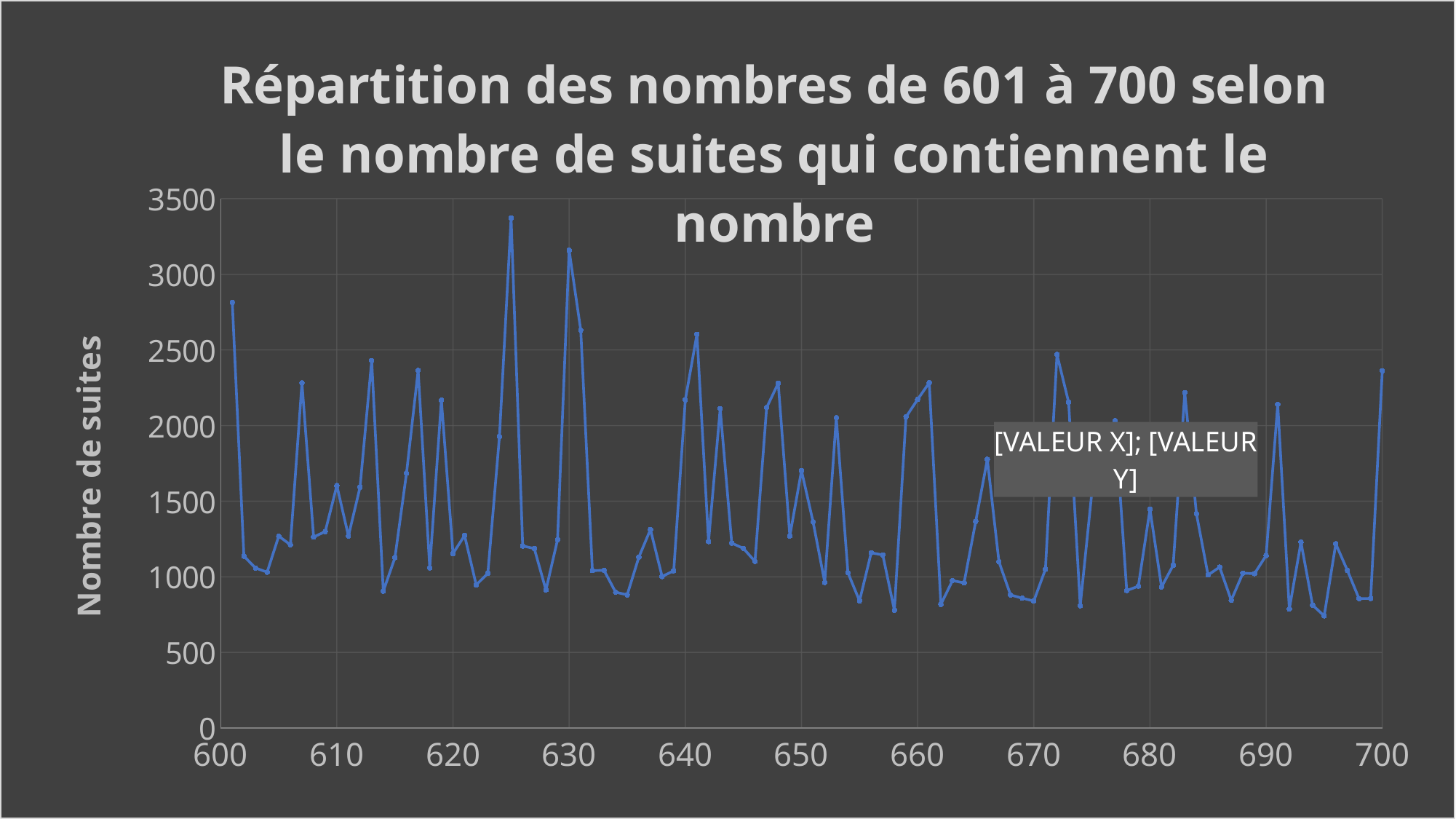
Is the value at x = 700 greater or less than 2000? greater Which has the larger value, x = 625 or x = 630? 625 Which has the larger value, x = 601 or x = 613? 601 Is the value at x = 601 greater or less than 2500? greater At which x value does the line reach its highest point? 625 Is the value at x = 625 greater or less than 3000? greater What is the label of the vertical axis? Nombre de suites What kind of chart is shown on the slide? line chart What is the title of the chart? Répartition des nombres de 601 à 700 selon le nombre de suites qui contiennent le nombre